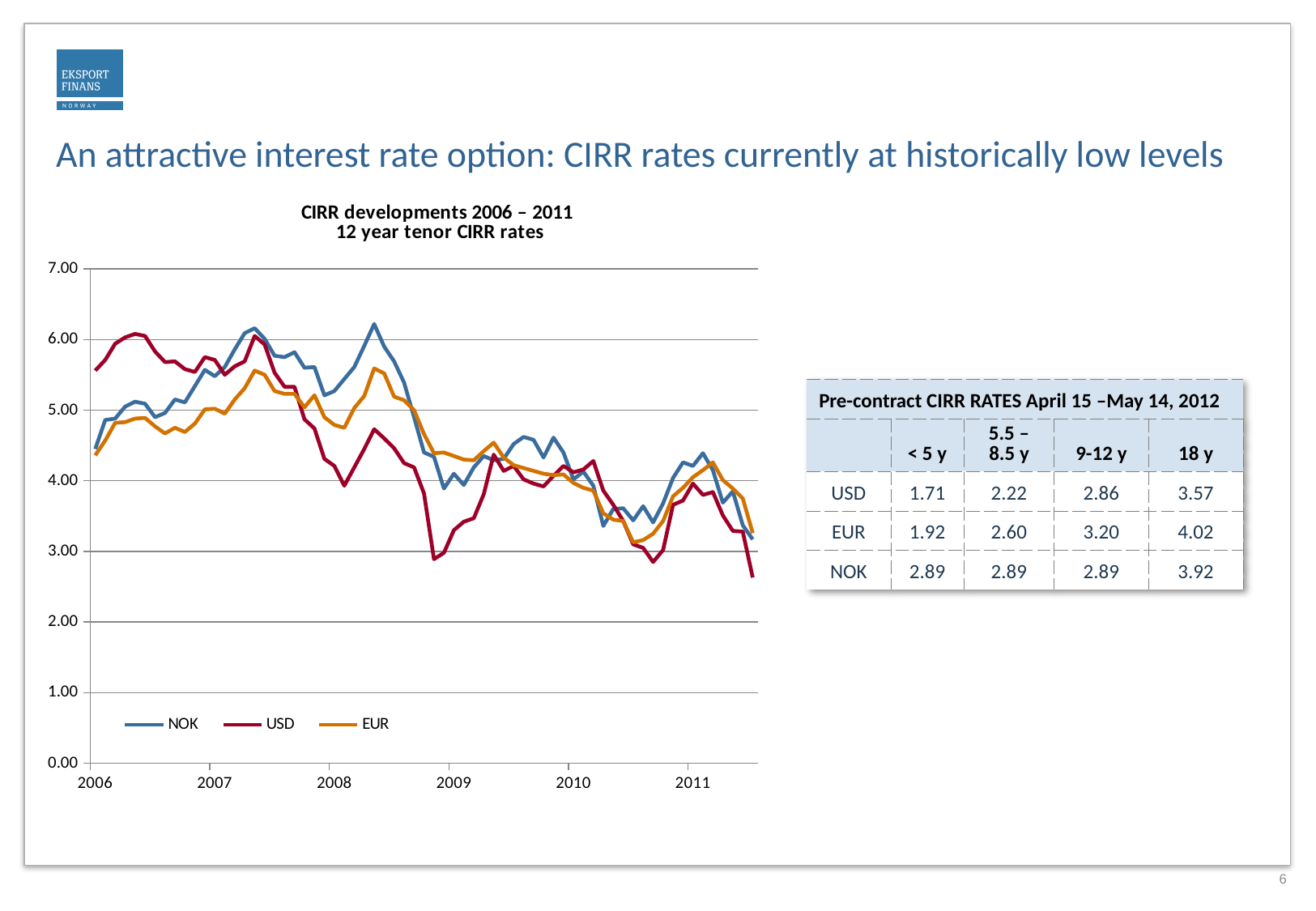
What is the title of the chart? CIRR developments 2006 – 2011 12 year tenor CIRR rates Which series reaches the highest peak during 2008? NOK Which colour is used for the NOK line in the chart? blue Overall, do the CIRR rates rise or fall from 2006 to 2011 in the chart? fall How many year labels are shown on the x axis of the chart? 6 At the start of 2006, which is higher, the USD line or the EUR line? USD Is the EUR value at the start of 2006 greater or less than 5.00? less Is the peak NOK value in 2008 greater or less than 6.00? greater Which series is lowest at the end of 2011? USD What kind of chart is shown on the slide? line chart How many series does the chart legend list? 3 Is the USD value at the end of 2011 greater or less than 3.00? less